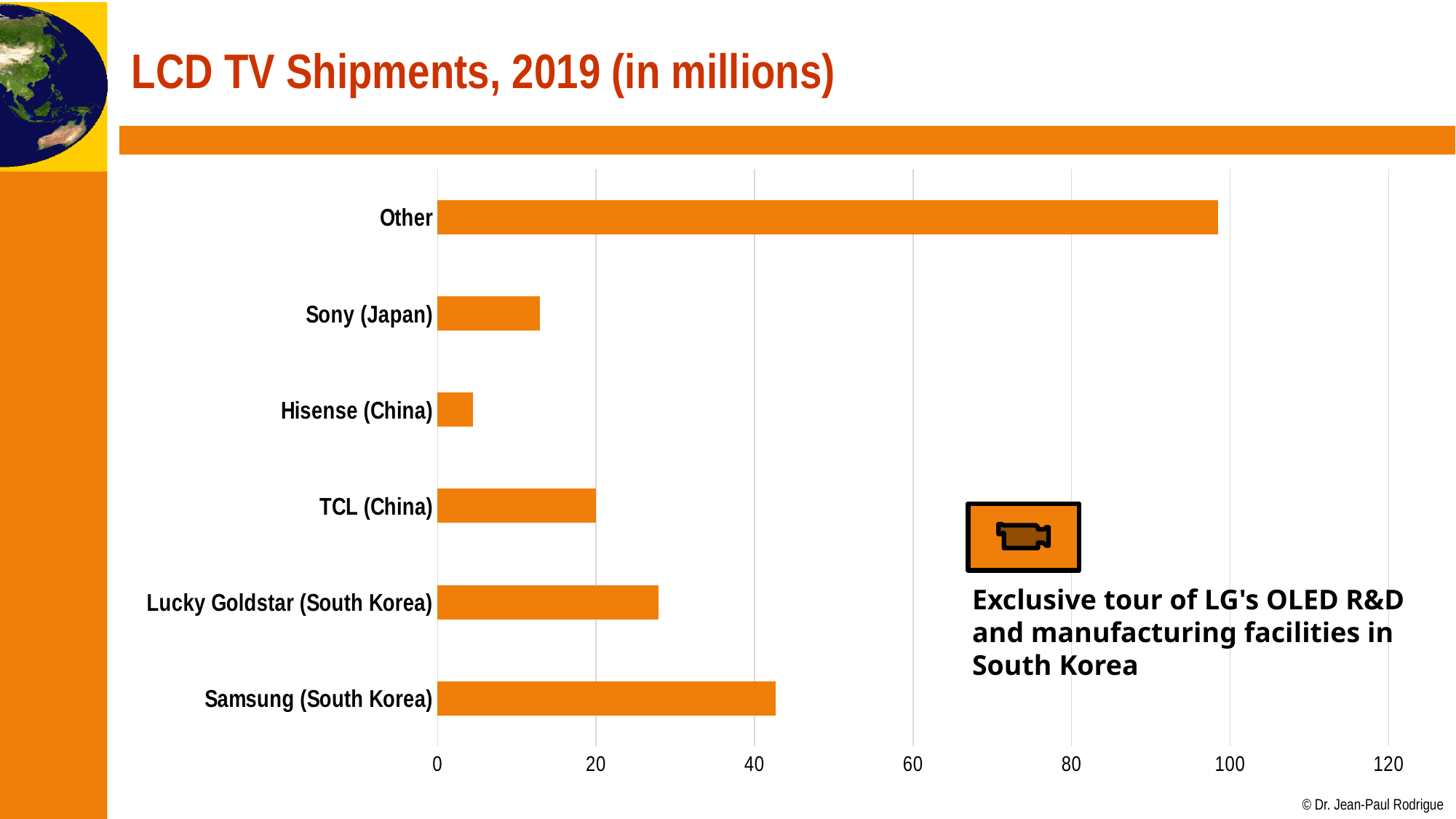
How many categories are plotted in the chart? 6 What kind of chart is shown on the slide? bar chart Which is larger, the value for Sony (Japan) or the value for TCL (China)? TCL (China) Is the value for Samsung (South Korea) greater or less than 40? greater Which category has the lowest value in the chart? Hisense (China) What colour are the bars in the chart? orange Is the value for Lucky Goldstar (South Korea) greater or less than 20? greater Is the value for Hisense (China) greater or less than 20? less What is the title of the slide containing the chart? LCD TV Shipments, 2019 (in millions) Which is larger, the value for Samsung (South Korea) or the value for Lucky Goldstar (South Korea)? Samsung (South Korea) Which category has the highest value in the chart? Other